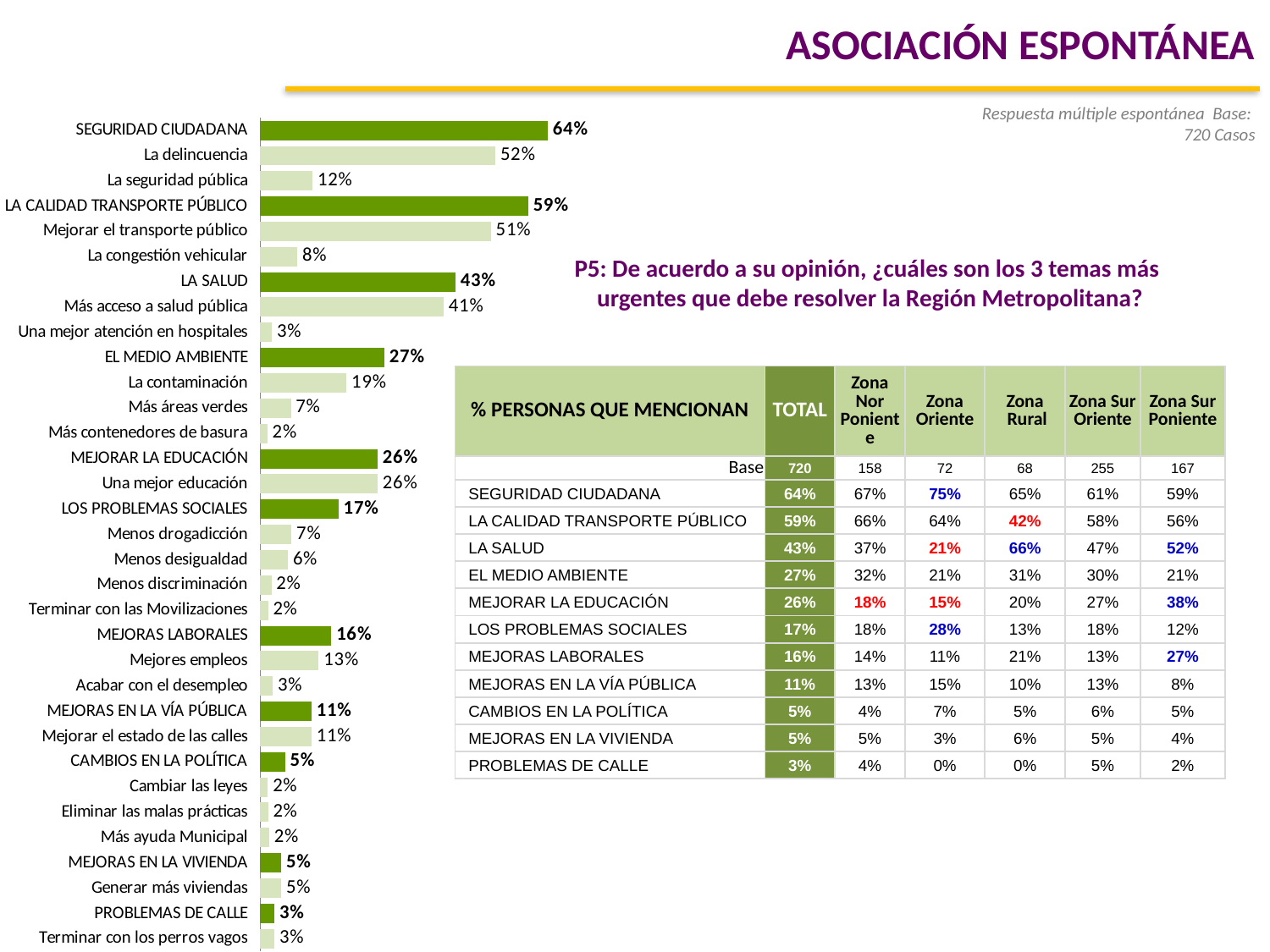
Which has a larger value in the bar chart, LOS PROBLEMAS SOCIALES or MEJORAS EN LA VÍA PÚBLICA? LOS PROBLEMAS SOCIALES Which category has the highest value in the bar chart? SEGURIDAD CIUDADANA What is the value shown for La contaminación in the bar chart? 19% Which has a larger value in the bar chart, Más acceso a salud pública or La seguridad pública? Más acceso a salud pública How many bars are plotted in the bar chart? 33 What is the value shown for LA SALUD in the bar chart? 43% What is the value shown for La congestión vehicular in the bar chart? 8% What kind of chart is shown on the left of the slide? Bar chart What is the value shown for SEGURIDAD CIUDADANA in the bar chart? 64% What is the difference between the values for LA SALUD and EL MEDIO AMBIENTE in the bar chart? 16 percentage points What is the value shown for Mejores empleos in the bar chart? 13% What is the difference between the values for SEGURIDAD CIUDADANA and LA CALIDAD TRANSPORTE PÚBLICO in the bar chart? 5 percentage points